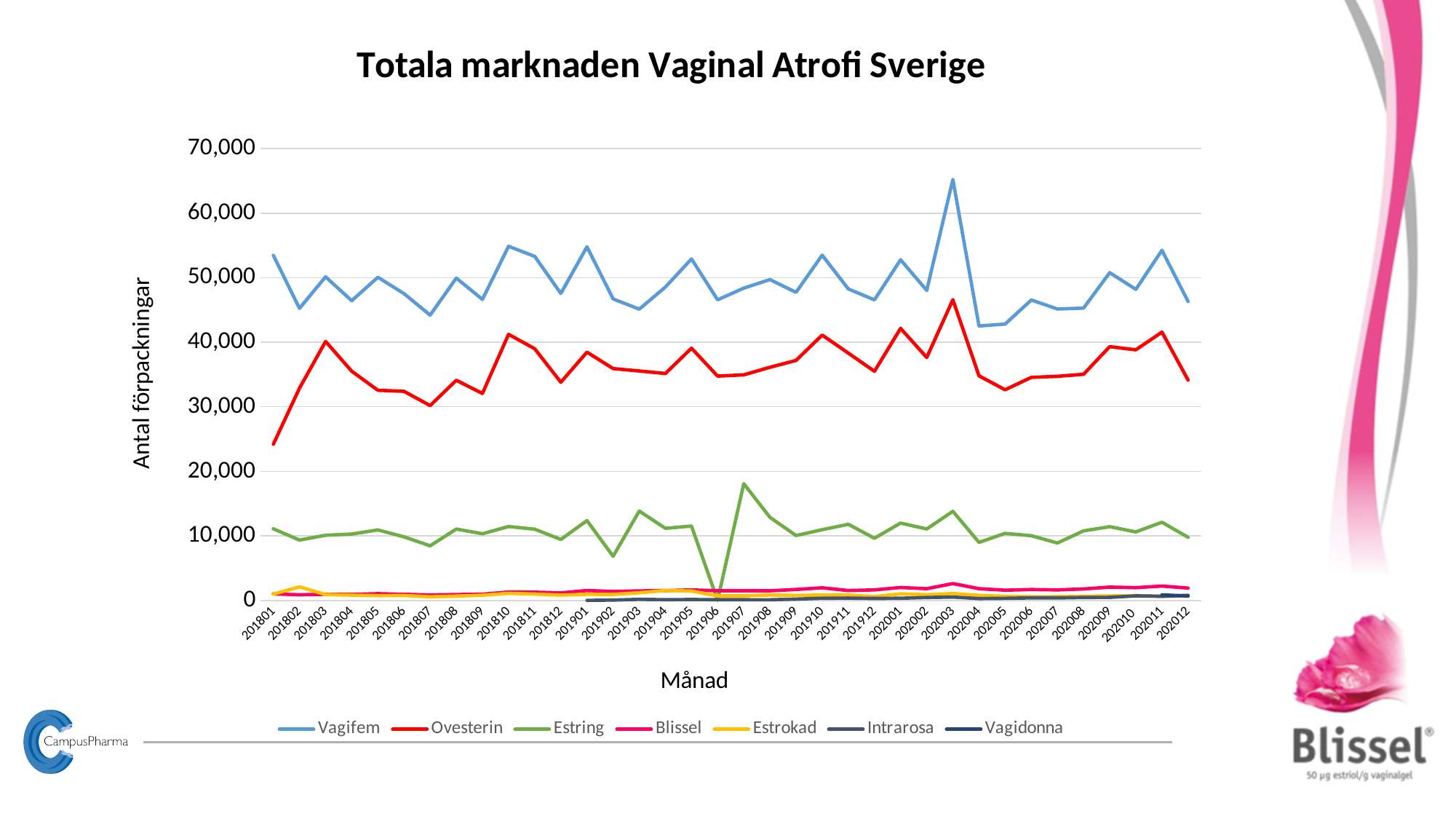
What is the title of the chart? Totala marknaden Vaginal Atrofi Sverige Is the value for Vagifem in 202003 greater or less than 60,000? greater What kind of chart is shown on the slide? line chart Is the value for Estring in 201907 greater or less than 15,000? greater How many months are plotted along the x axis? 36 In which month does the Vagifem series reach its highest point? 202003 Is the value for Estring in 201906 greater or less than 10,000? less Which series has the highest values across the whole period? Vagifem Which is larger in 201801, the value for Vagifem or the value for Ovesterin? Vagifem How many series does the legend list? 7 Does the Ovesterin series rise or fall from 202003 to 202004? fall